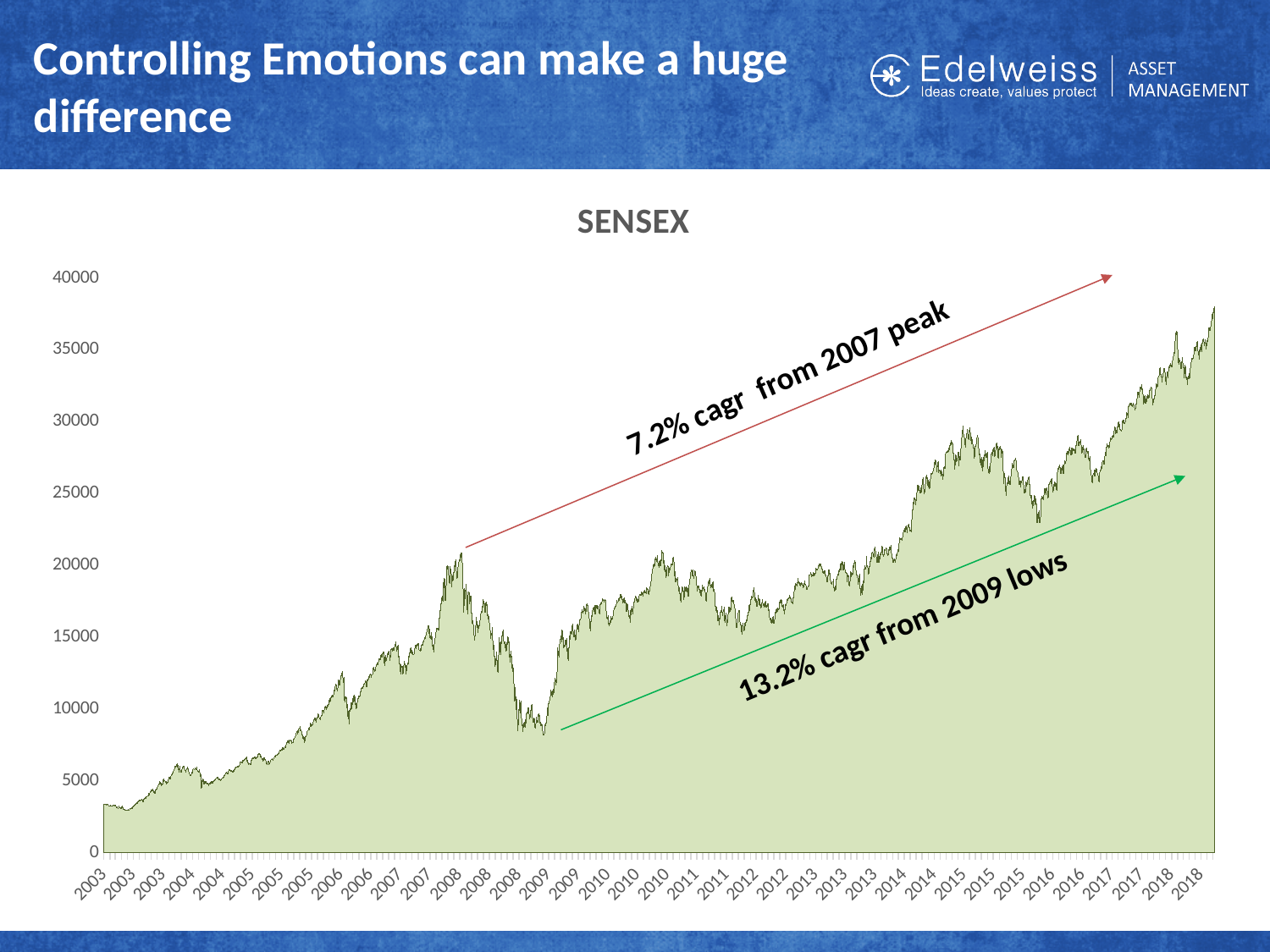
What is the title of the chart? SENSEX What CAGR does the chart annotation give from the 2007 peak? 7.2% Is the SENSEX peak in early 2008 greater or less than 15000? greater What kind of chart is shown on the slide? Area chart How many distinct years are labelled along the x axis, from 2003 to 2018? 16 What is the highest value shown on the y axis? 40000 Is the SENSEX low in early 2009 greater or less than 10000? less Overall, does the SENSEX value rise or fall from 2003 to 2018? Rise Which annotated CAGR is higher: from the 2007 peak or from the 2009 lows? From the 2009 lows (13.2%) What CAGR does the chart annotation give from the 2009 lows? 13.2% Is the SENSEX value at the start of 2003 greater or less than 5000? less